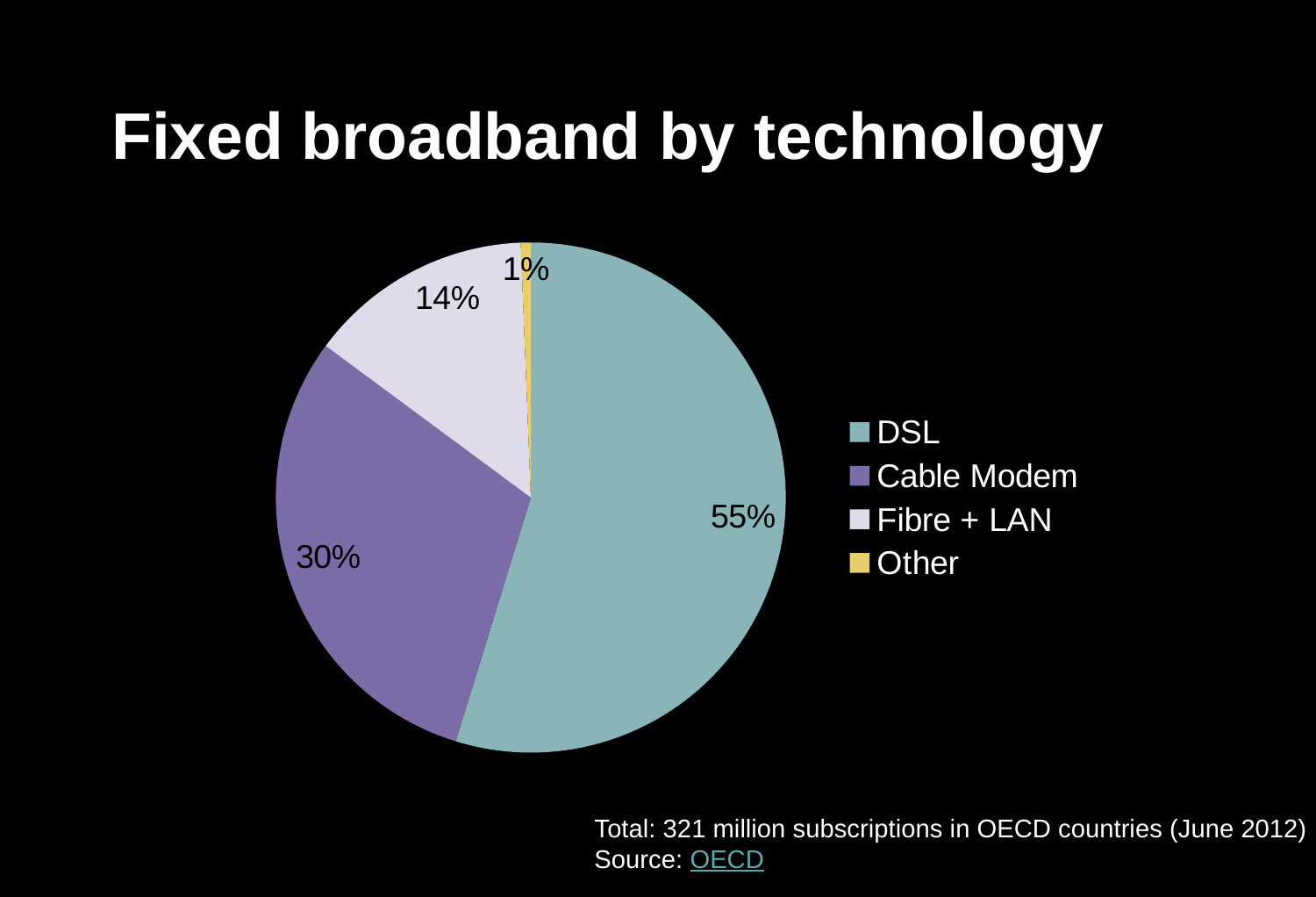
What share of fixed broadband subscriptions is Fibre + LAN? 14% What kind of chart is shown on the slide? pie chart What share of fixed broadband subscriptions is Other? 1% What share of fixed broadband subscriptions is DSL? 55% Which has a larger share, Cable Modem or Fibre + LAN? Cable Modem Which technology has the smallest share of the pie? Other What is the difference in percentage points between the DSL and Cable Modem shares? 25 What is the title of the chart? Fixed broadband by technology How many entries does the legend list? 4 Which technology has the largest share of the pie? DSL How many slices does the pie chart have? 4